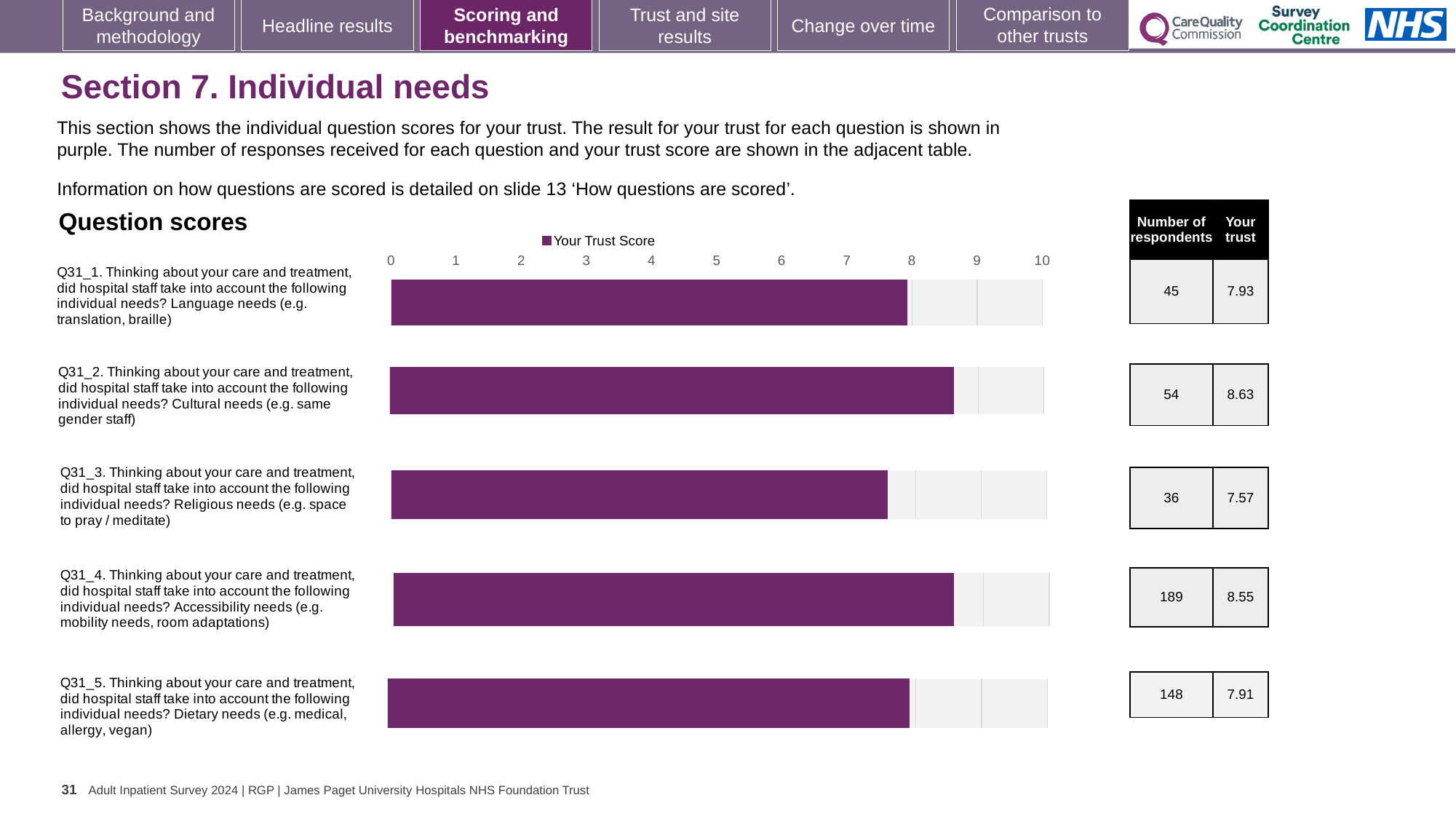
Which question has the lowest trust score? Q31_3 (Religious needs) What kind of chart is shown on the slide? Bar chart Which has the larger trust score, Q31_4 (Accessibility needs) or Q31_3 (Religious needs)? Q31_4 (Accessibility needs) Is the trust score for Q31_2 (Cultural needs) greater or less than 8? greater Is the trust score for Q31_3 (Religious needs) greater or less than 8? less Which question has the highest trust score? Q31_2 (Cultural needs) How many series does the chart legend list? 1 What is the trust score for Q31_2 (Cultural needs)? 8.63 How many questions are plotted in the chart? 5 What is the trust score for Q31_3 (Religious needs)? 7.57 What is the trust score for Q31_5 (Dietary needs)? 7.91 What is the difference between the trust scores for Q31_2 and Q31_3? 1.06